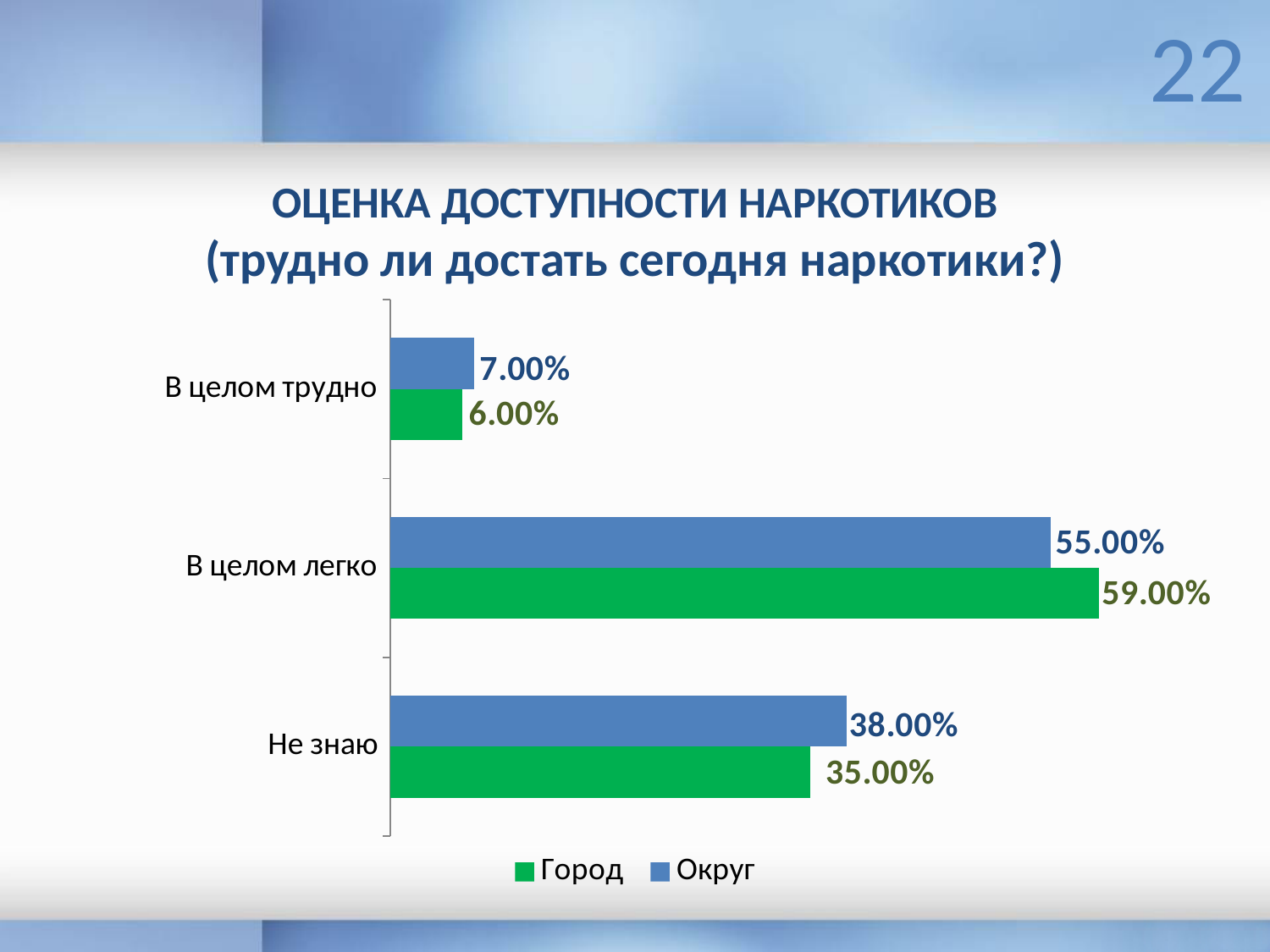
What is the value for Город in the category Не знаю? 35.00% How many series does the legend list? 2 What is the value for Округ in the category В целом трудно? 7.00% What is the value for Округ in the category Не знаю? 38.00% What is the difference between the Город and Округ values in the category В целом легко? 4.00% In the category Не знаю, which series has the larger value, Город or Округ? Округ How many categories are shown on the chart? 3 What kind of chart is shown on the slide? Bar chart Which colour represents the Город series in the legend? Green Which category has the lowest value for the Округ series? В целом трудно Which category has the highest value for the Город series? В целом легко What is the value for Город in the category В целом легко? 59.00%